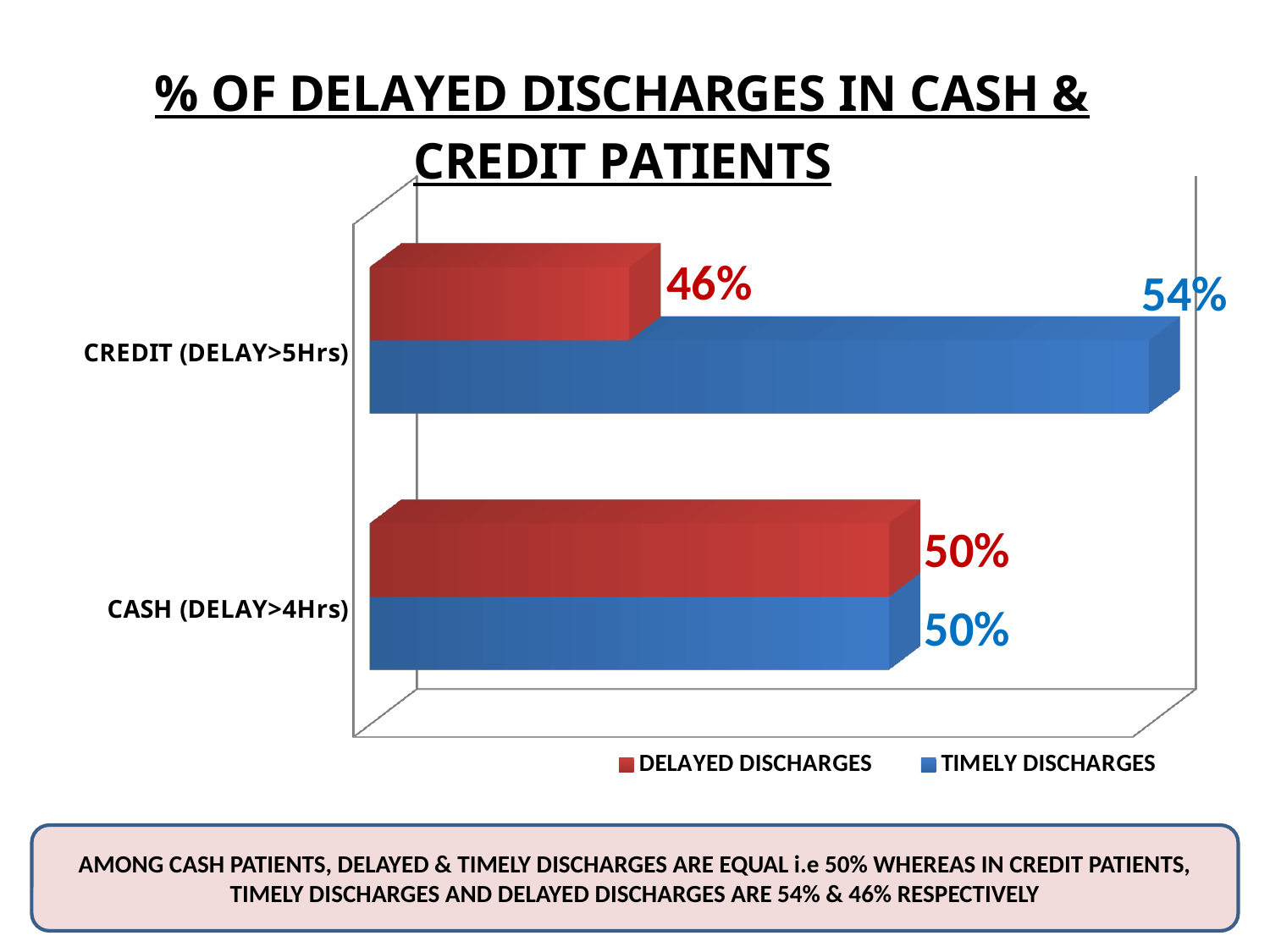
How many series does the legend list? 2 Which category has the highest TIMELY DISCHARGES value? CREDIT (DELAY>5Hrs) In the CREDIT (DELAY>5Hrs) category, which is larger: DELAYED DISCHARGES or TIMELY DISCHARGES? TIMELY DISCHARGES How many categories are shown on the chart? 2 Which category has the lowest DELAYED DISCHARGES value? CREDIT (DELAY>5Hrs) What kind of chart is shown on the slide? Bar chart Which colour represents DELAYED DISCHARGES in the legend? Red What is the difference between TIMELY DISCHARGES and DELAYED DISCHARGES in the CREDIT (DELAY>5Hrs) category? 8% What is the value for DELAYED DISCHARGES in the CASH (DELAY>4Hrs) category? 50% What is the value for TIMELY DISCHARGES in the CREDIT (DELAY>5Hrs) category? 54% What is the value for TIMELY DISCHARGES in the CASH (DELAY>4Hrs) category? 50% What is the value for DELAYED DISCHARGES in the CREDIT (DELAY>5Hrs) category? 46%